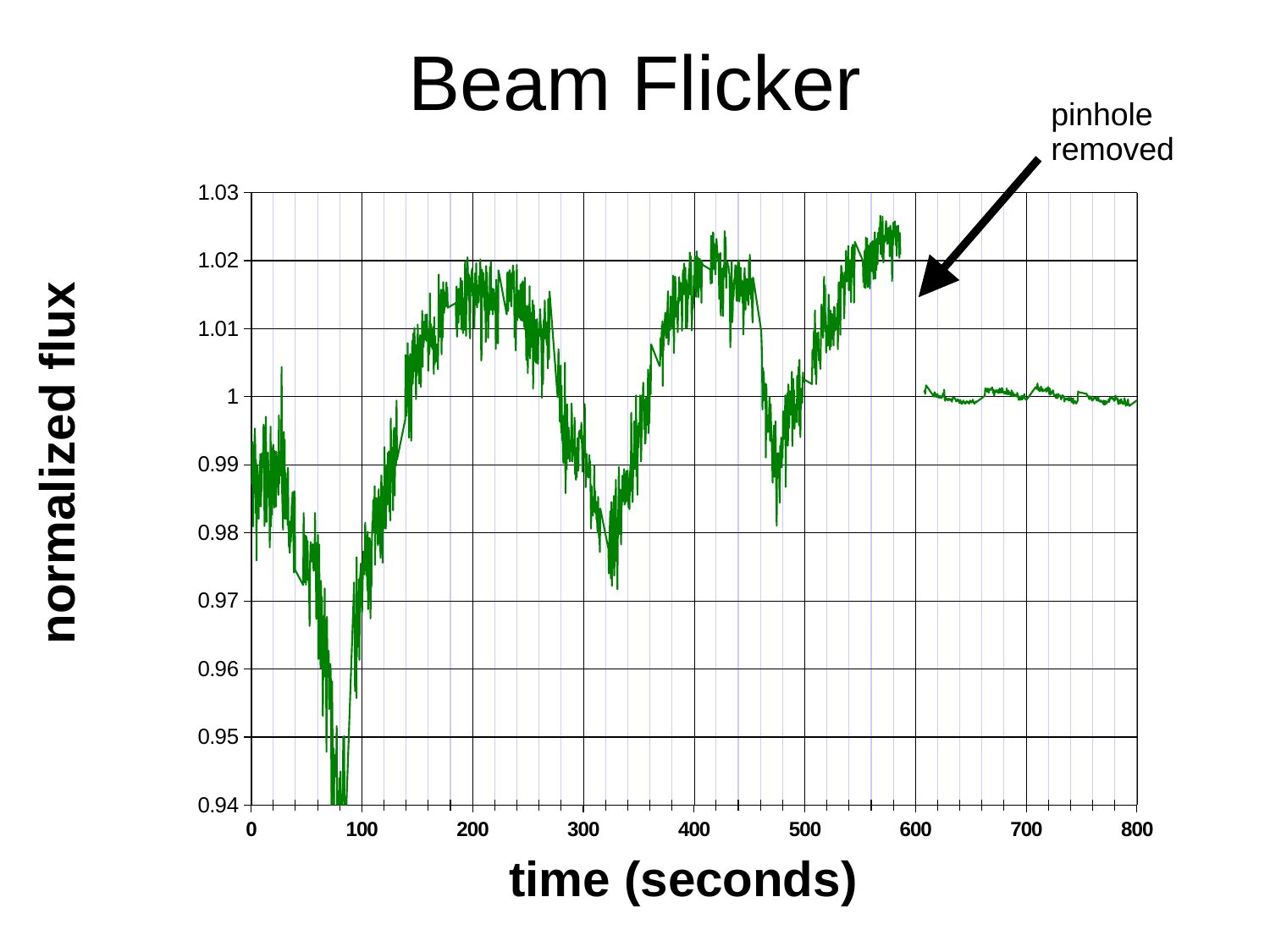
Is the normalized flux at around 700 seconds greater or less than 1.01? less What is the maximum value shown on the y axis? 1.03 Does the normalized flux rise or fall between about 250 and 325 seconds? fall Does the normalized flux rise or fall between about 100 and 200 seconds? rise Is the normalized flux at around 200 seconds greater or less than 1.01? greater Is the normalized flux at around 480 seconds greater or less than 1? less What is the label of the x axis? time (seconds) What kind of chart is shown on the slide? line chart What is the title of the chart? Beam Flicker